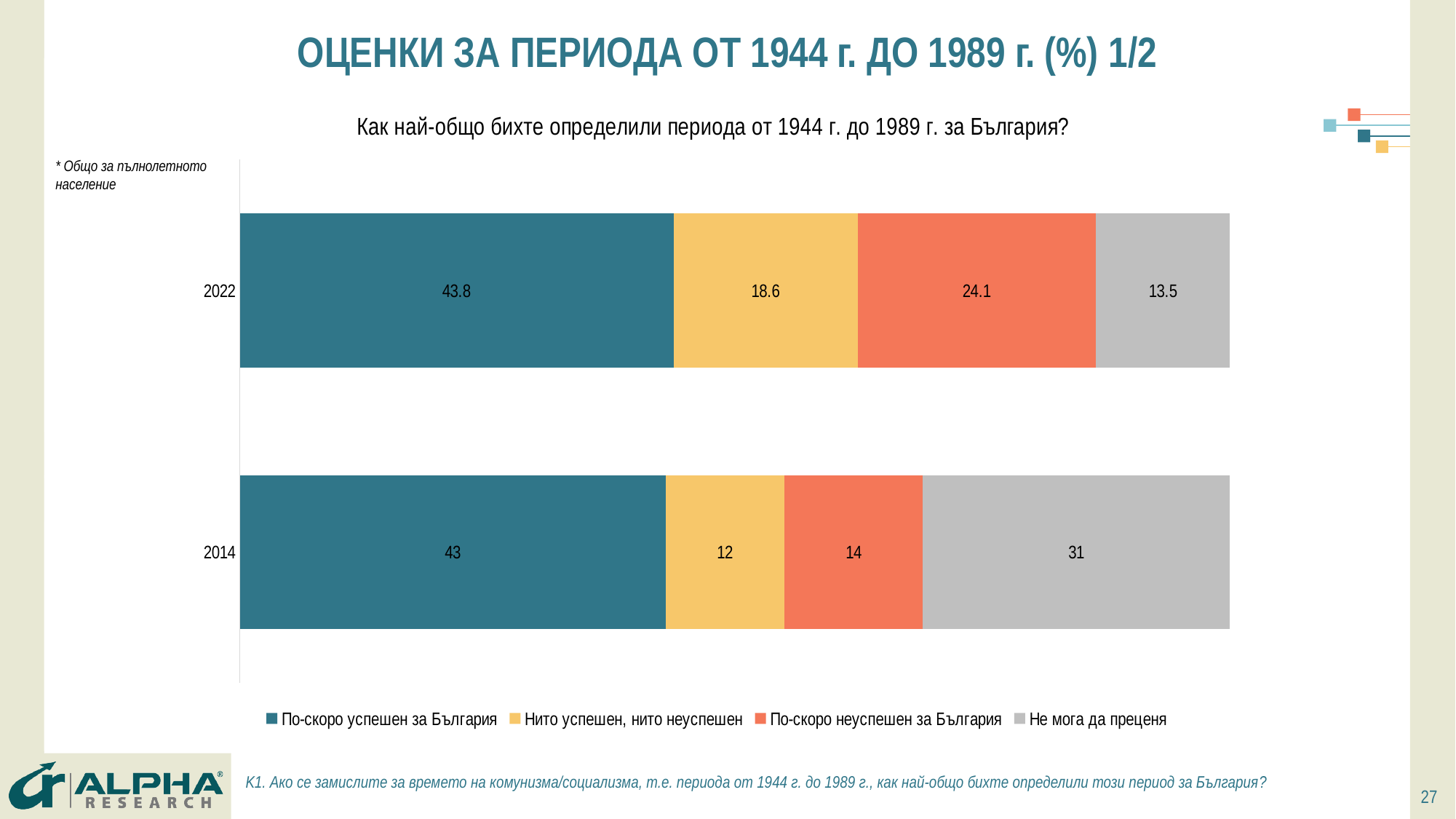
What is the value for "Нито успешен, нито неуспешен" in 2022? 18.6 What is the value for "Не мога да преценя" in 2014? 31 What is the value for "По-скоро успешен за България" in 2022? 43.8 Which response has the highest value in 2022? По-скоро успешен за България Which response has the lowest value in 2014? Нито успешен, нито неуспешен What is the total of the stacked bar for 2014? 100 Which is larger: "Не мога да преценя" in 2022 or in 2014? 2014 What is the value for "По-скоро неуспешен за България" in 2014? 14 How many series does the legend list? 4 How many years (categories) are shown on the chart? 2 What kind of chart is shown on the slide? Stacked bar chart What is the difference between the "По-скоро неуспешен за България" values for 2022 and 2014? 10.1